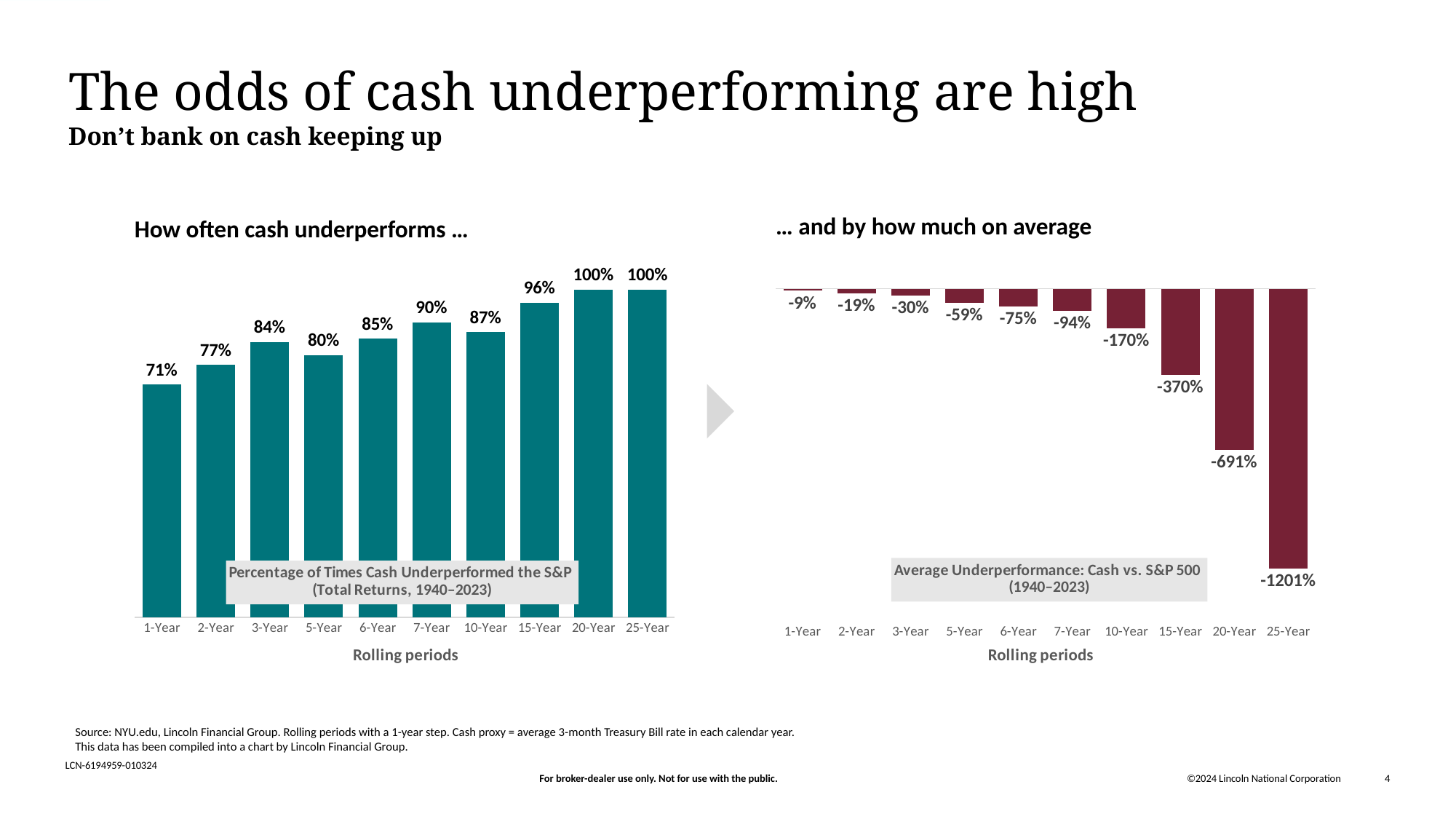
In the right chart (... and by how much on average), what is the value for the 15-Year rolling period? -370% In the left chart (How often cash underperforms), what is the value for the 10-Year rolling period? 87% In the right chart (... and by how much on average), what is the value for the 6-Year rolling period? -75% In the left chart (How often cash underperforms), how many rolling periods are shown? 10 In the left chart (How often cash underperforms), is the value for 5-Year or 7-Year larger? 7-Year In the right chart (... and by how much on average), what is the title shown in the box inside the plot area? Average Underperformance: Cash vs. S&P 500 (1940–2023) What kind of chart is the right chart (... and by how much on average)? Bar chart In the right chart (... and by how much on average), which rolling period has the lowest (most negative) value? 25-Year In the left chart (How often cash underperforms), what is the difference between the 15-Year and 1-Year values? 25% In the right chart (... and by how much on average), what is the difference between the 20-Year and 10-Year values? 521% In the left chart (How often cash underperforms), what is the value for the 3-Year rolling period? 84% In the left chart (How often cash underperforms), which rolling period has the lowest value? 1-Year